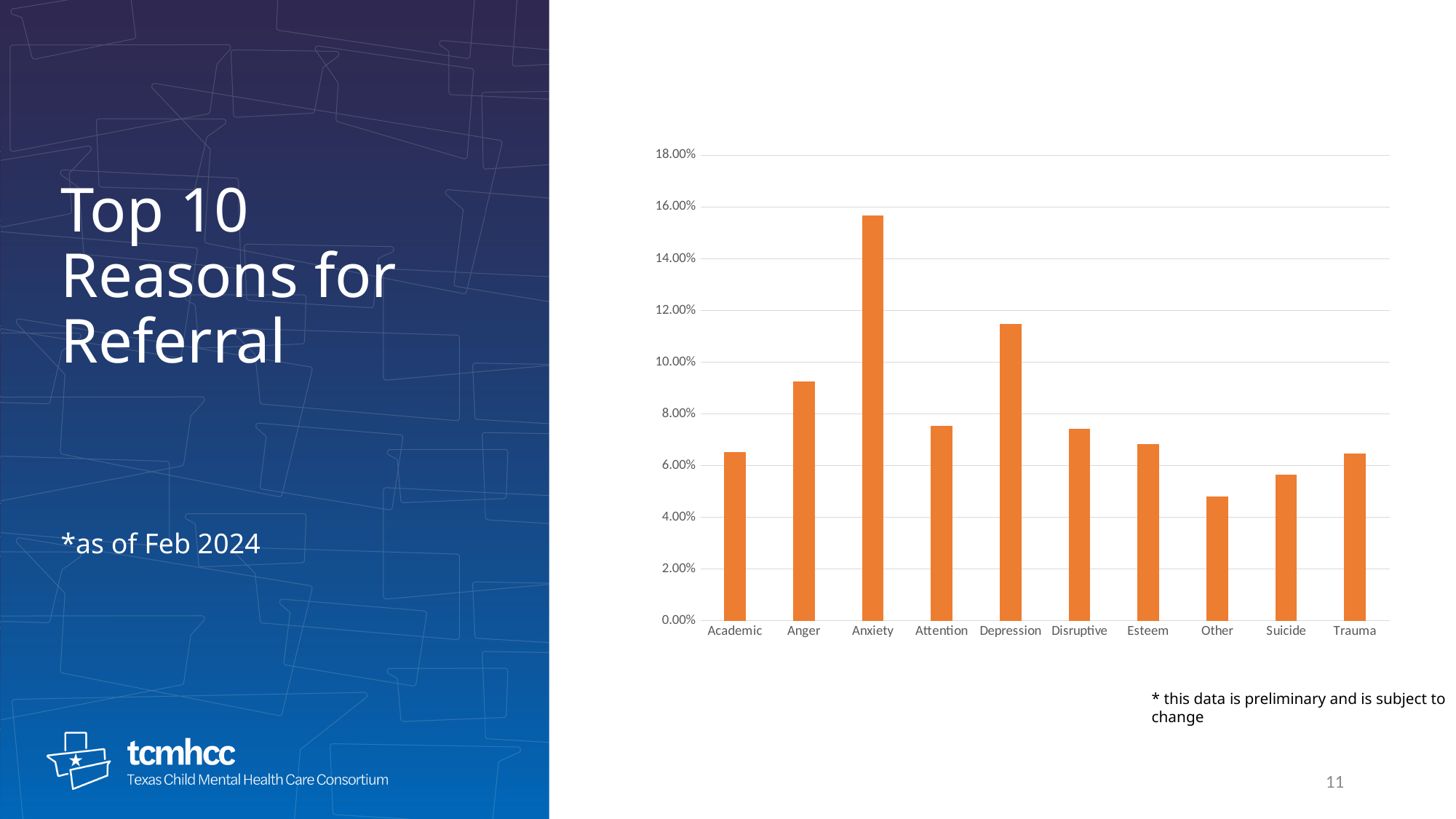
Which reason for referral has the highest value? Anxiety Which is larger, the value for Depression or the value for Anger? Depression Is the value for Anxiety greater or less than 14.00%? greater What is the title of the slide containing the chart? Top 10 Reasons for Referral What kind of chart is shown on the slide? bar chart Is the value for Attention greater or less than 8.00%? less Is the value for Other greater or less than 6.00%? less Which is larger, the value for Suicide or the value for Other? Suicide How many reasons for referral are plotted on the chart? 10 Which reason for referral has the lowest value? Other